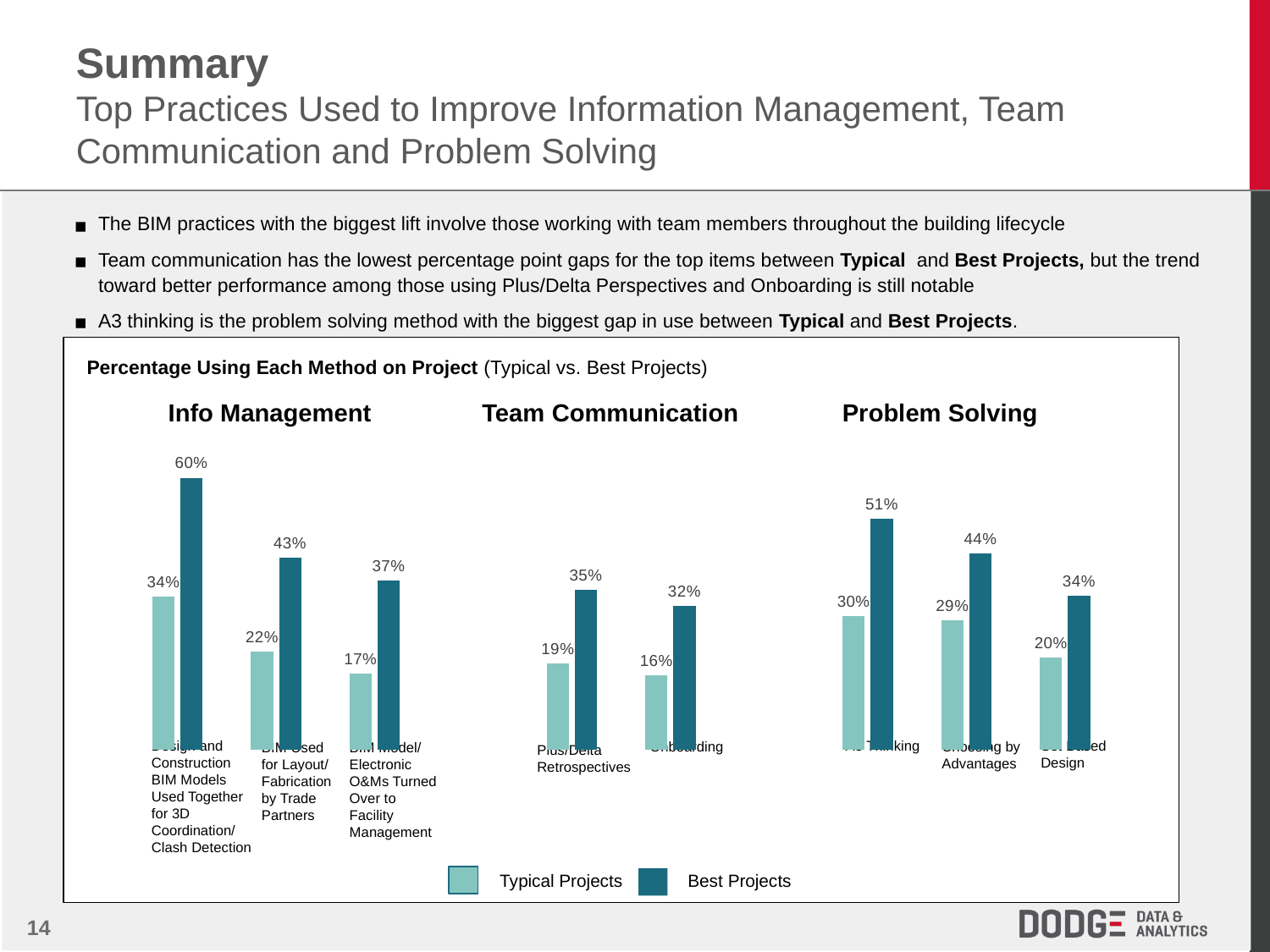
In the Problem Solving chart, which method has the highest value for Best Projects? A3 Thinking In the Problem Solving chart, what is the percentage point difference between Best Projects and Typical Projects for A3 Thinking? 21 How many methods are shown in the Team Communication chart? 2 In the Info Management chart, what percentage of Typical Projects use BIM for Layout/Fabrication by Trade Partners? 22% In the Problem Solving chart, what percentage of Typical Projects use A3 Thinking? 30% What type of chart is the Info Management chart? Bar chart In the Team Communication chart, what percentage of Best Projects use Onboarding? 32% In the Info Management chart, which method has the lowest value for Typical Projects? BIM Model/Electronic O&Ms Turned Over to Facility Management How many series does the legend list for the charts? 2 In the Info Management chart, what percentage of Best Projects use Design and Construction BIM Models Used Together for 3D Coordination/Clash Detection? 60% In the Problem Solving chart, what is the percentage of Best Projects using Choosing by Advantages? 44% In the Team Communication chart, which is larger: the Typical Projects value for Plus/Delta Retrospectives or the Typical Projects value for Onboarding? Plus/Delta Retrospectives